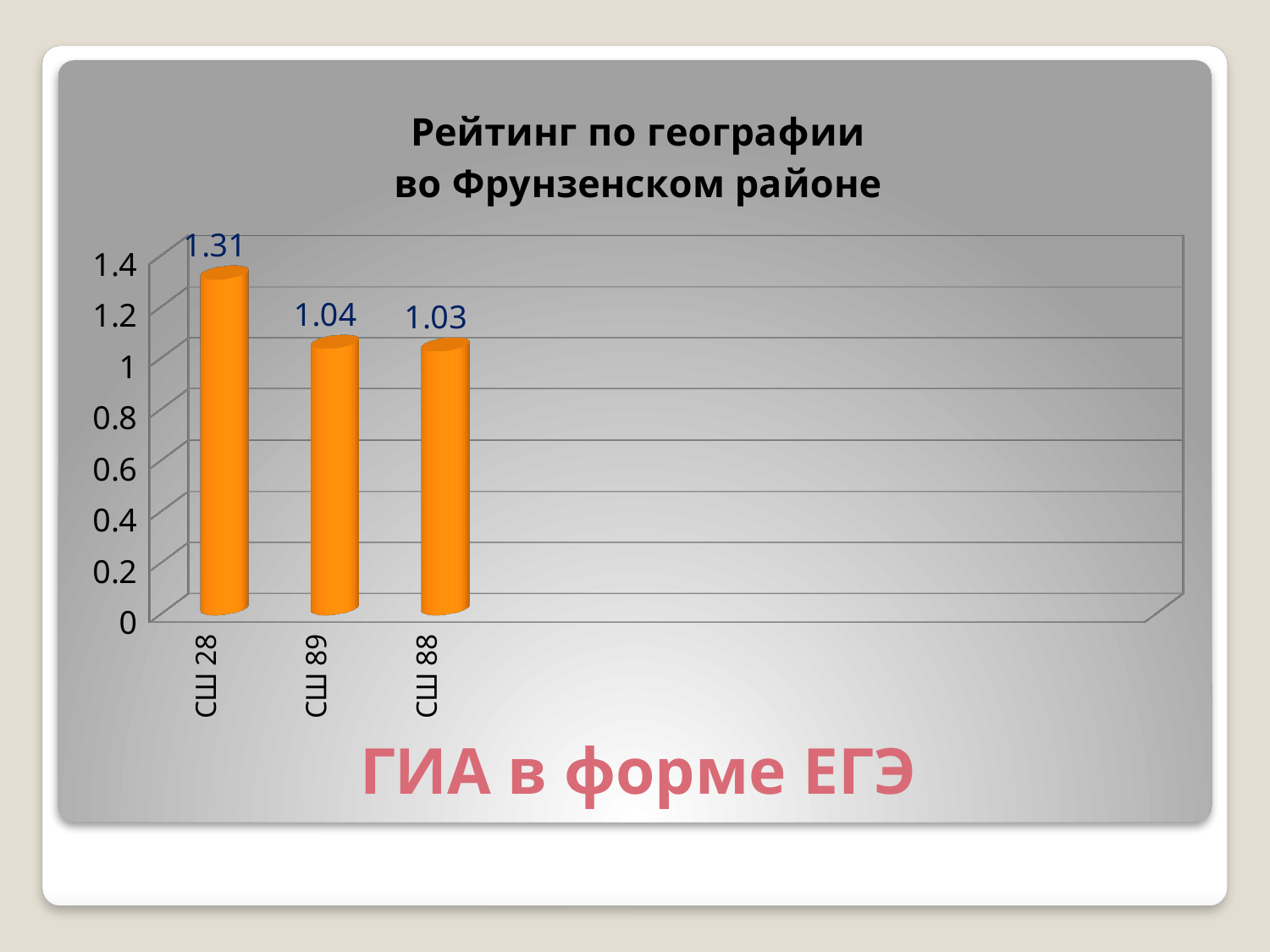
How many schools are shown on the chart? 3 What is the difference between the values for СШ 28 and СШ 89? 0.27 What is the value for СШ 88? 1.03 Is the value for СШ 28 greater or less than 1.2? greater What is the title of the chart? Рейтинг по географии во Фрунзенском районе What is the value for СШ 28? 1.31 What is the value for СШ 89? 1.04 Is the value for СШ 89 greater or less than 1.2? less Which is larger, the value for СШ 28 or the value for СШ 88? СШ 28 Which school has the highest rating? СШ 28 What kind of chart is shown on the slide? bar chart What is the difference between the values for СШ 28 and СШ 88? 0.28